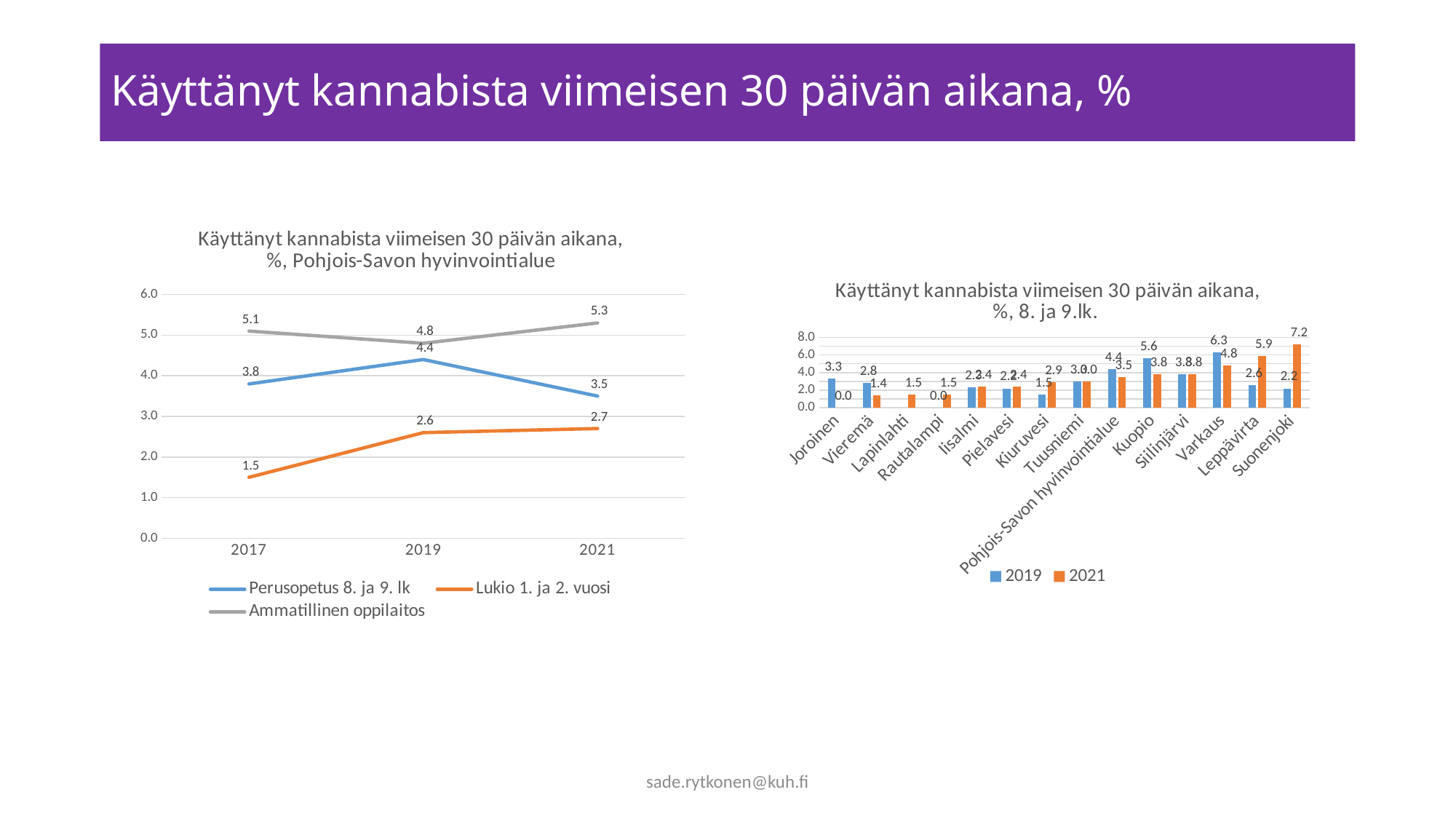
What kind of chart is the chart on the left, titled 'Käyttänyt kannabista viimeisen 30 päivän aikana, %, Pohjois-Savon hyvinvointialue'? line chart How many series does the legend of the left chart (Pohjois-Savon hyvinvointialue) list? 3 In the right chart (8. ja 9.lk.), what is the difference between the 2019 and 2021 values for Kuopio? 1.8 In the left chart (Pohjois-Savon hyvinvointialue), which series has the highest value in 2017? Ammatillinen oppilaitos In the left chart (Pohjois-Savon hyvinvointialue), what is the value for Ammatillinen oppilaitos in 2021? 5.3 In the right chart (8. ja 9.lk.), which municipality has the highest 2019 value? Varkaus In the left chart (Pohjois-Savon hyvinvointialue), what is the value for Lukio 1. ja 2. vuosi in 2017? 1.5 In the right chart (8. ja 9.lk.), which is larger for Leppävirta, the 2019 value or the 2021 value? 2021 In the left chart (Pohjois-Savon hyvinvointialue), what is the difference between the Perusopetus 8. ja 9. lk values for 2019 and 2021? 0.9 What kind of chart is the chart on the right, titled 'Käyttänyt kannabista viimeisen 30 päivän aikana, %, 8. ja 9.lk.'? bar chart In the left chart (Pohjois-Savon hyvinvointialue), does the Lukio 1. ja 2. vuosi line rise or fall from 2017 to 2021? rise In the right chart (8. ja 9.lk.), what is the 2021 value for Suonenjoki? 7.2